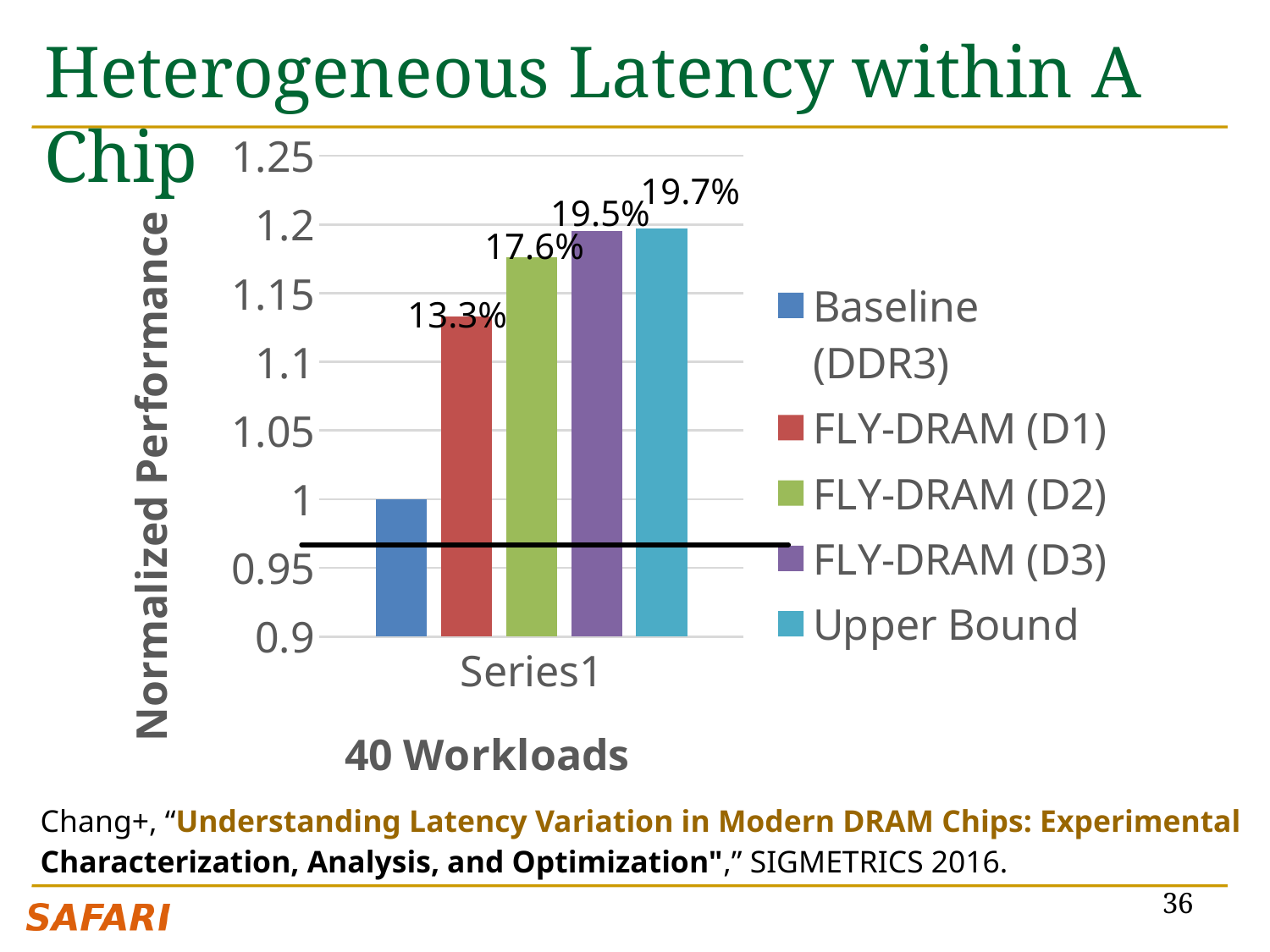
What is the data label shown above the Upper Bound bar? 19.7% What is the data label shown above the FLY-DRAM (D2) bar? 17.6% What is the difference between the Upper Bound label and the FLY-DRAM (D1) label? 6.4 percentage points Is the value for FLY-DRAM (D2) greater or less than 1.15? greater What kind of chart is shown on the slide? bar chart What is the data label shown above the FLY-DRAM (D3) bar? 19.5% What normalized performance value does the Baseline (DDR3) bar reach? 1 What is the data label shown above the FLY-DRAM (D1) bar? 13.3% How many series does the legend list? 5 Which is larger, the FLY-DRAM (D2) bar or the FLY-DRAM (D1) bar? FLY-DRAM (D2) Which of the labeled bars has the smallest percentage label? FLY-DRAM (D1) What is the label on the vertical axis of the chart? Normalized Performance